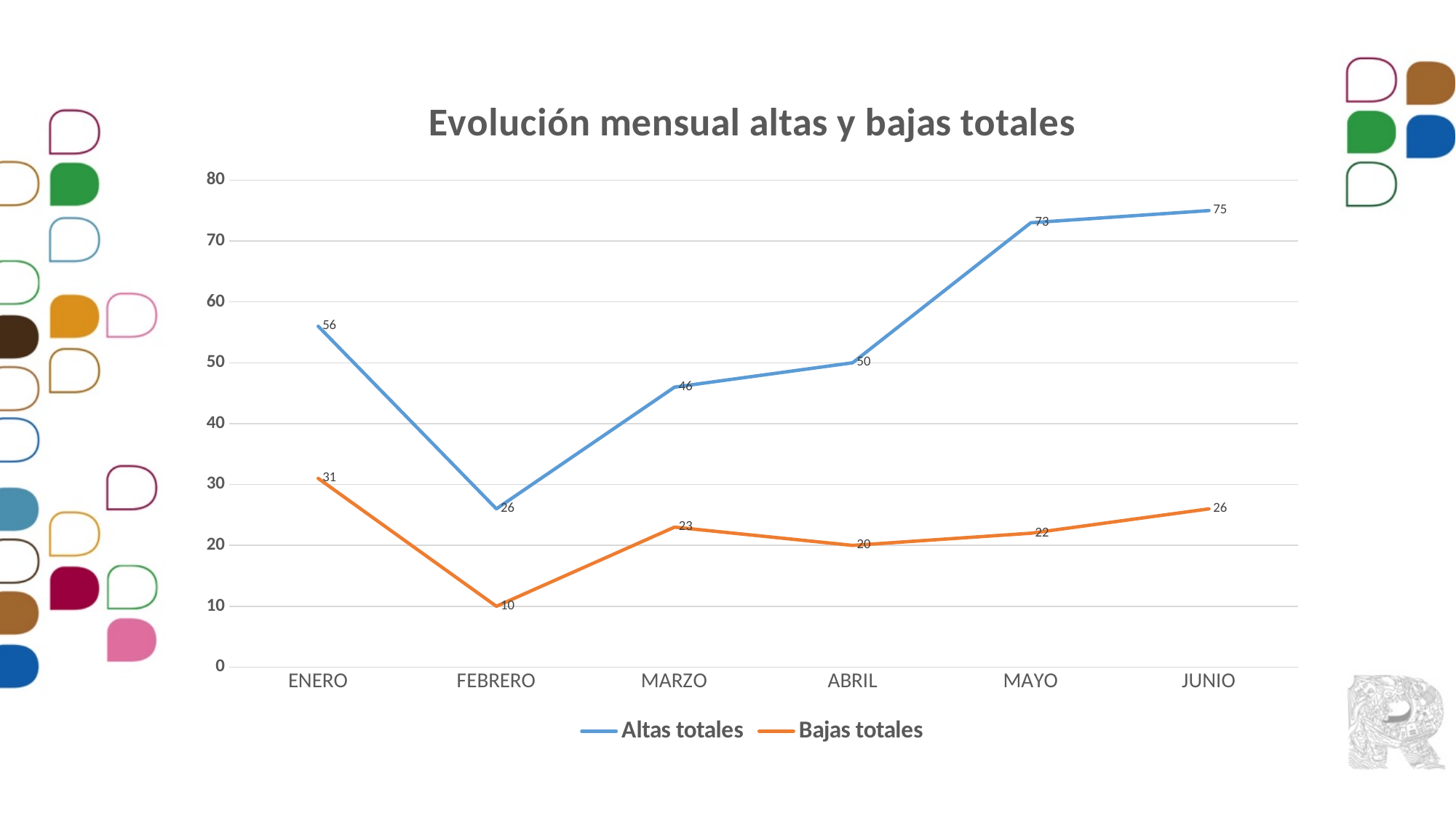
What is the title of the chart? Evolución mensual altas y bajas totales What is the value of Bajas totales in FEBRERO? 10 What is the difference between Altas totales and Bajas totales in MAYO? 51 In which month is Bajas totales lowest? FEBRERO What is the value of Altas totales in ENERO? 56 Does Altas totales rise or fall from MARZO to JUNIO? Rise Which is larger in ABRIL, Altas totales or Bajas totales? Altas totales What is the value of Altas totales in JUNIO? 75 How many series does the legend list? 2 What kind of chart is this? Line chart In which month is Altas totales highest? JUNIO How many months are shown on the x axis? 6